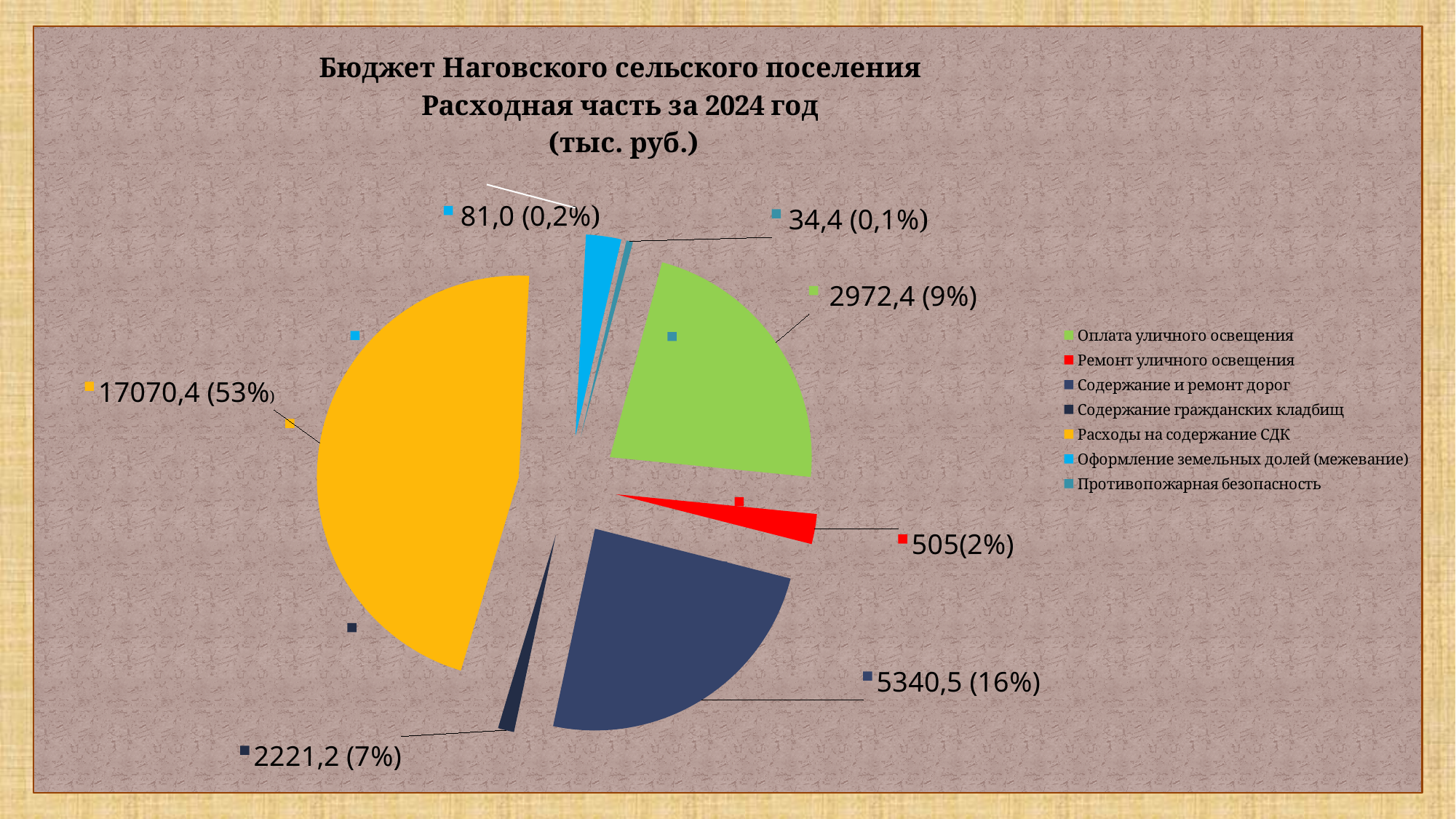
What is the value for Оплата уличного освещения? 2972,4 How many entries does the legend list? 7 What is the value for Расходы на содержание СДК? 17070,4 Which category has the largest slice? Расходы на содержание СДК What is the difference between the values for Оплата уличного освещения and Содержание гражданских кладбищ? 751,2 What share of the pie does Содержание гражданских кладбищ take? 7% What is the value for Содержание и ремонт дорог? 5340,5 Which is larger, Содержание и ремонт дорог or Оплата уличного освещения? Содержание и ремонт дорог What share of the pie does Ремонт уличного освещения take? 2% What is the value for Противопожарная безопасность? 34,4 Which category has the smallest slice? Противопожарная безопасность What kind of chart is shown on the slide? pie chart